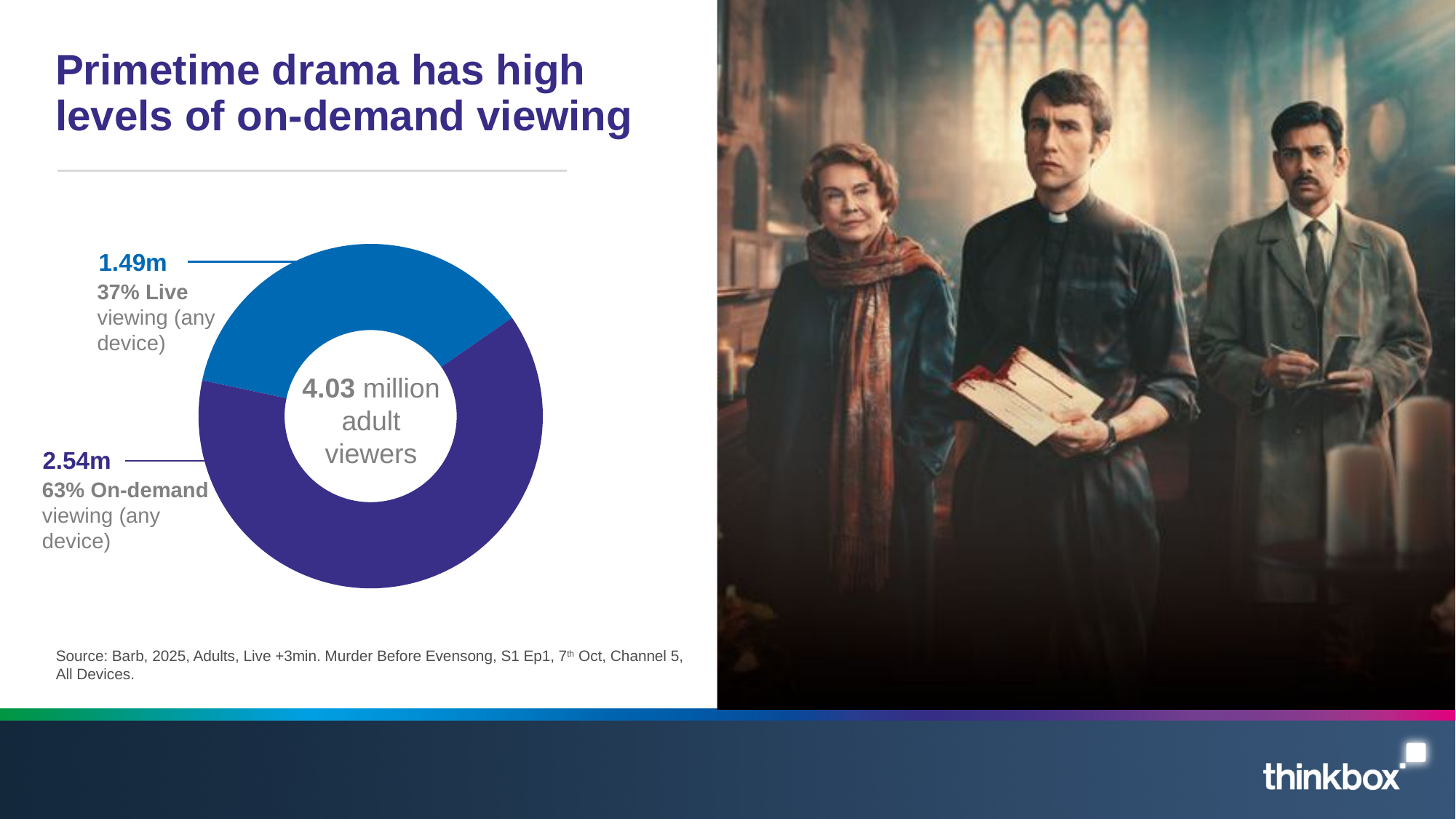
What is the value for Live viewing (any device)? 1.49m What share of viewing is On-demand? 63% What is the difference in millions between On-demand and Live viewing? 1.05m What colour is the On-demand segment? Purple What kind of chart is shown on the slide? Doughnut (pie) chart What share of viewing is Live? 37% What is the value for On-demand viewing (any device)? 2.54m Which segment is larger, Live or On-demand viewing? On-demand How many adult viewers does the centre of the chart report in total? 4.03 million Which segment is the smallest? Live viewing (any device) How many segments does the chart have? 2 What is the title of the slide? Primetime drama has high levels of on-demand viewing